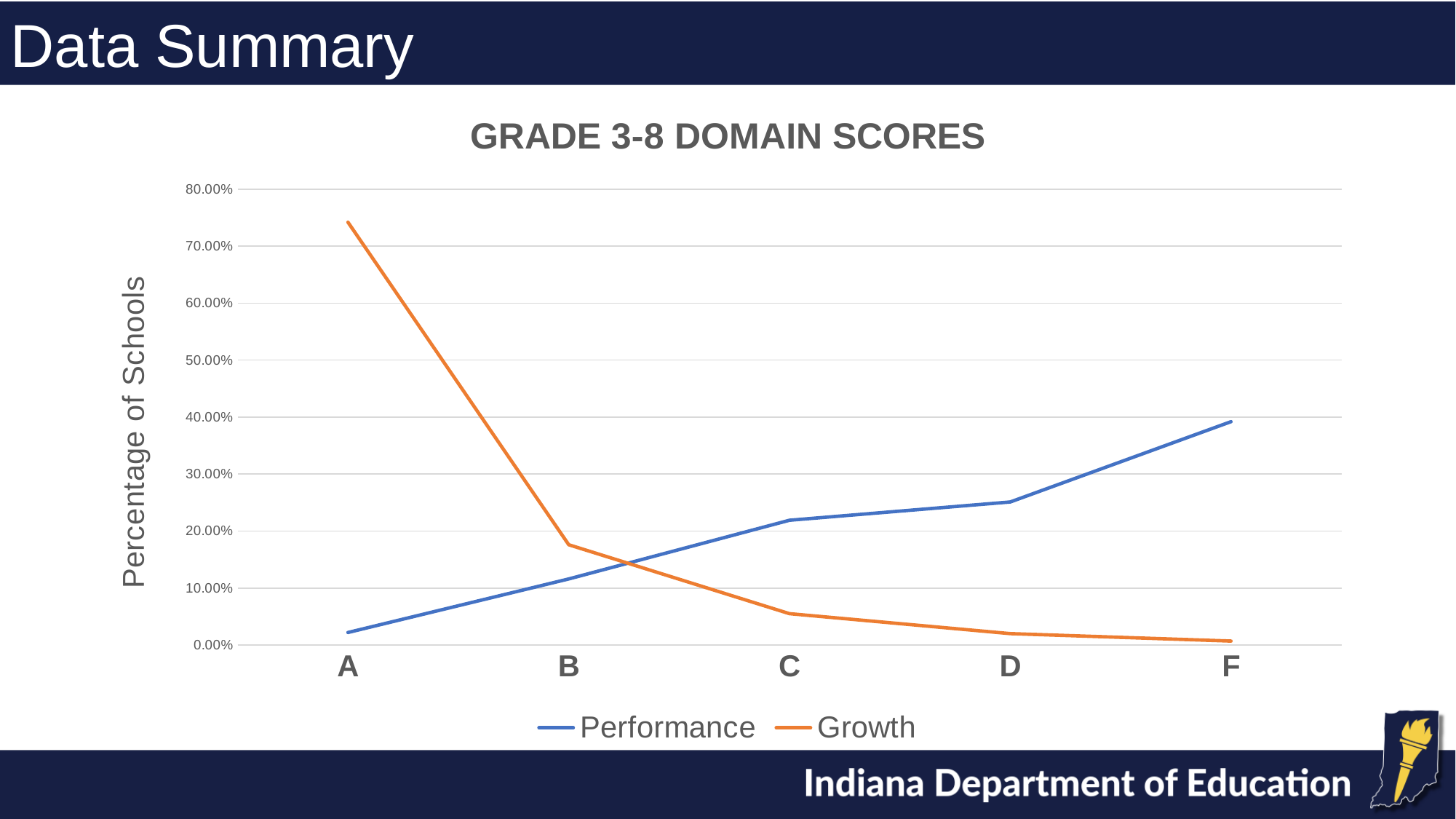
At which grade is the Growth series highest? A Is the Growth value for grade C greater or less than 10.00%? less At grade A, which series has the larger value, Performance or Growth? Growth At which grade is the Growth series lowest? F At which grade is the Performance series highest? F Does the Performance series rise or fall from A to F? rise How many categories are shown on the x axis? 5 Is the Growth value for grade A greater or less than 70.00%? greater What kind of chart is shown on the slide? line chart How many series does the legend list? 2 Is the Performance value for grade F greater or less than 30.00%? greater At which grade is the Performance series lowest? A